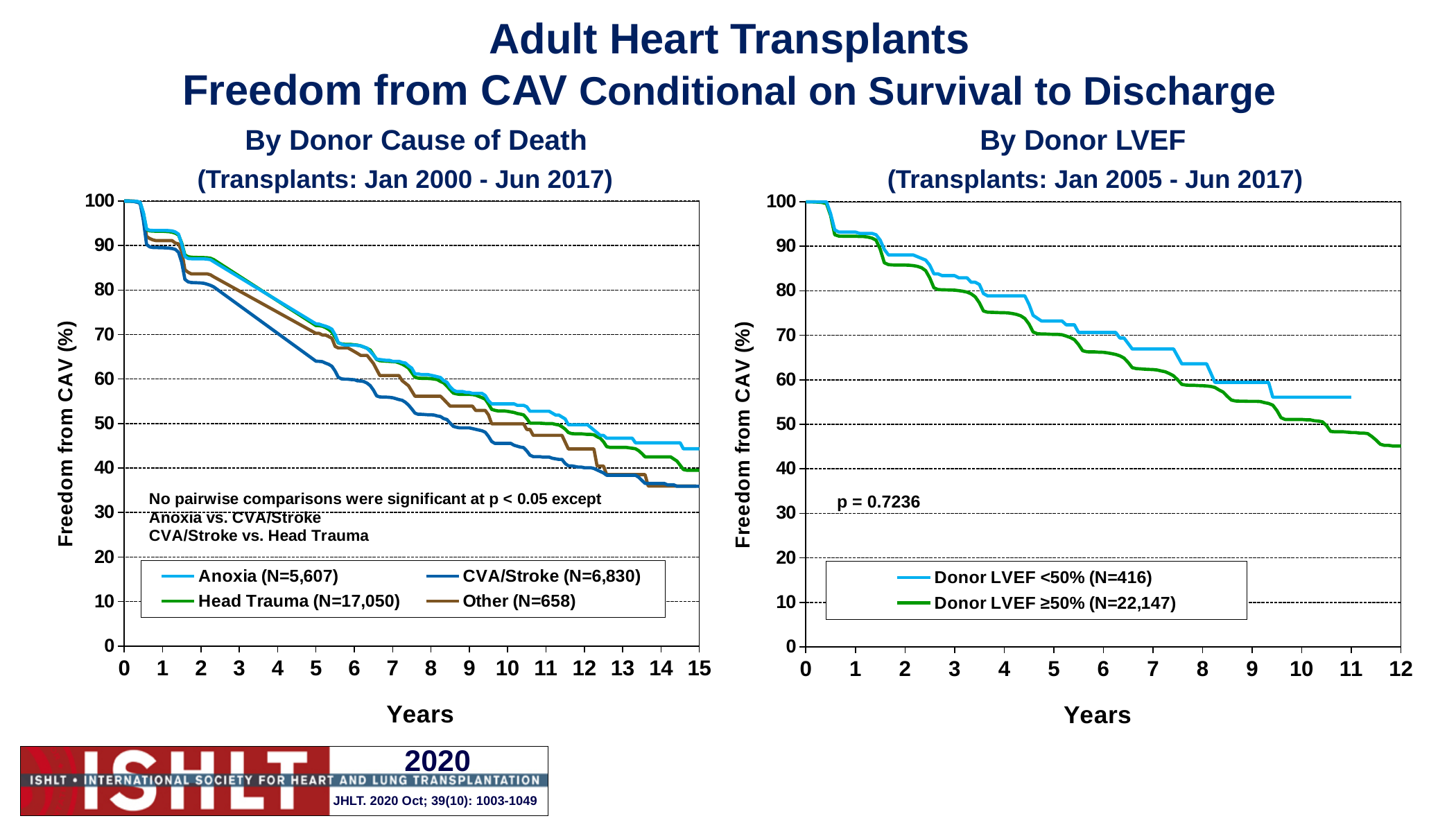
In the left chart, 'By Donor Cause of Death', is the value for Anoxia at year 10 greater or less than 50? greater In the left chart, 'By Donor Cause of Death', is the value for CVA/Stroke at year 5 greater or less than 60? greater How many series does the legend of the right chart, 'By Donor LVEF', list? 2 How many series does the legend of the left chart, 'By Donor Cause of Death', list? 4 In the right chart, 'By Donor LVEF', is the value for Donor LVEF ≥50% at year 12 greater or less than 50? less In the left chart, 'By Donor Cause of Death', what is the N for the Head Trauma group shown in the legend? N=17,050 In the left chart, 'By Donor Cause of Death', which is higher at year 5: Anoxia or CVA/Stroke? Anoxia In the right chart, 'By Donor LVEF', what is the N for the Donor LVEF <50% group shown in the legend? N=416 In the left chart, 'By Donor Cause of Death', do the curves rise or fall as years increase? Fall What kind of chart is shown on the left, 'By Donor Cause of Death'? Line chart In the right chart, 'By Donor LVEF', which series is higher at year 8: Donor LVEF <50% or Donor LVEF ≥50%? Donor LVEF <50% In the right chart, 'By Donor LVEF', what p-value is printed on the chart? p = 0.7236